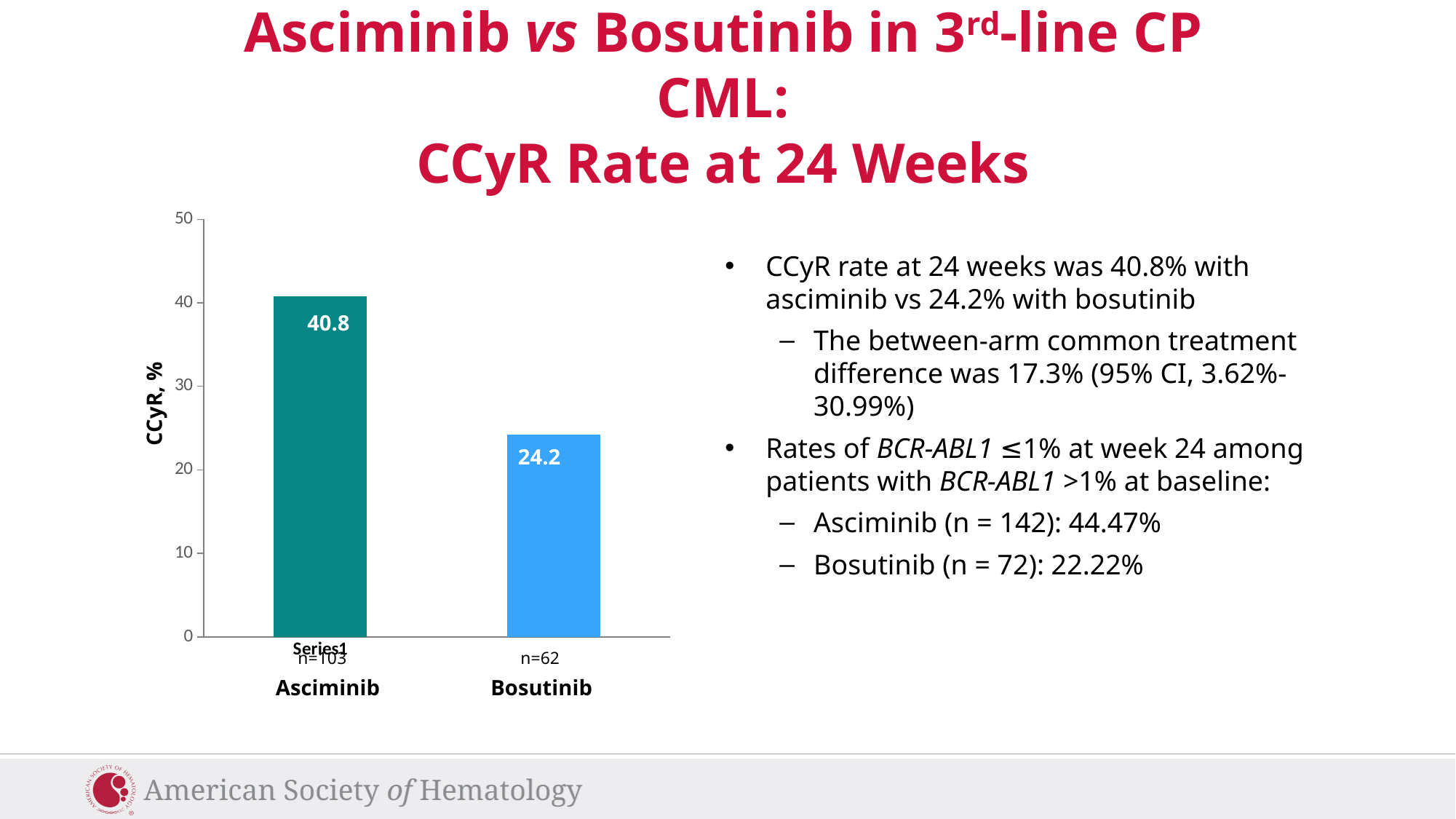
Is the value for Asciminib greater or less than 40? greater What is the CCyR rate shown for Asciminib in the bar chart? 40.8 Which treatment has the lower CCyR rate in the chart? Bosutinib What is the CCyR rate shown for Bosutinib in the bar chart? 24.2 Is the value for Bosutinib greater or less than 30? less Which treatment has the higher CCyR rate in the chart? Asciminib Is the CCyR rate for Asciminib larger or smaller than that for Bosutinib? larger How many bars are plotted in the chart? 2 What is the difference between the CCyR rates for Asciminib and Bosutinib in the chart? 16.6 What kind of chart is shown on the slide? bar chart What is the maximum value shown on the y axis of the chart? 50 What is the label of the y axis of the chart? CCyR, %